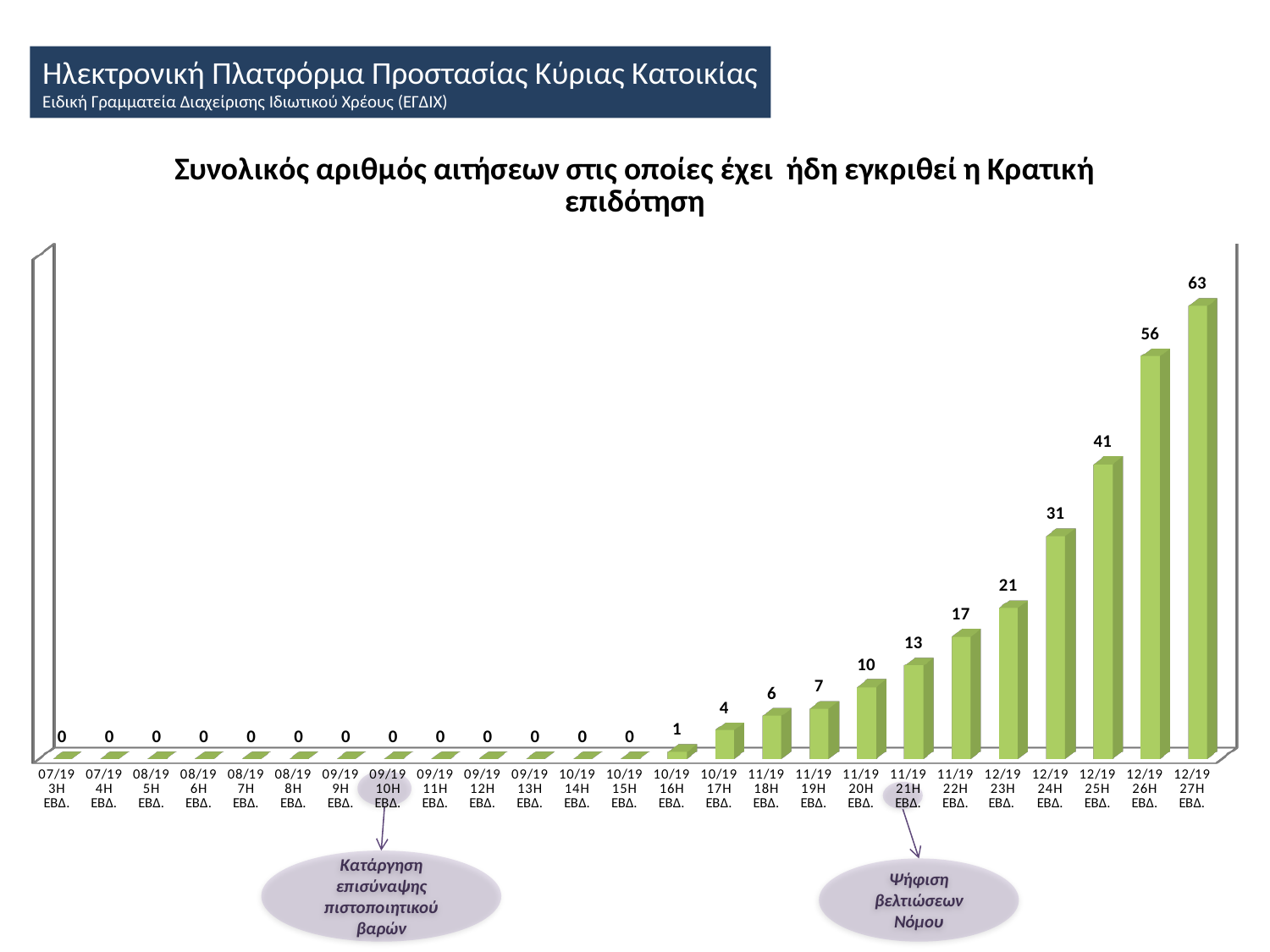
Which category has the highest value? 12/19 27H ΕΒΔ. How many categories are shown on the x axis? 25 What is the difference between the values for 12/19 27H ΕΒΔ. and 12/19 26H ΕΒΔ.? 7 What is the value for 11/19 21H ΕΒΔ.? 13 What is the value for 10/19 16H ΕΒΔ.? 1 What is the value for 12/19 24H ΕΒΔ.? 31 Which is larger, the value for 11/19 22H ΕΒΔ. or the value for 11/19 20H ΕΒΔ.? 11/19 22H ΕΒΔ. What is the title of the chart? Συνολικός αριθμός αιτήσεων στις οποίες έχει ήδη εγκριθεί η Κρατική επιδότηση What is the difference between the values for 12/19 25H ΕΒΔ. and 12/19 24H ΕΒΔ.? 10 What is the value for 12/19 27H ΕΒΔ.? 63 What type of chart is shown on the slide? bar chart Do the values rise or fall from left to right along the x axis? rise